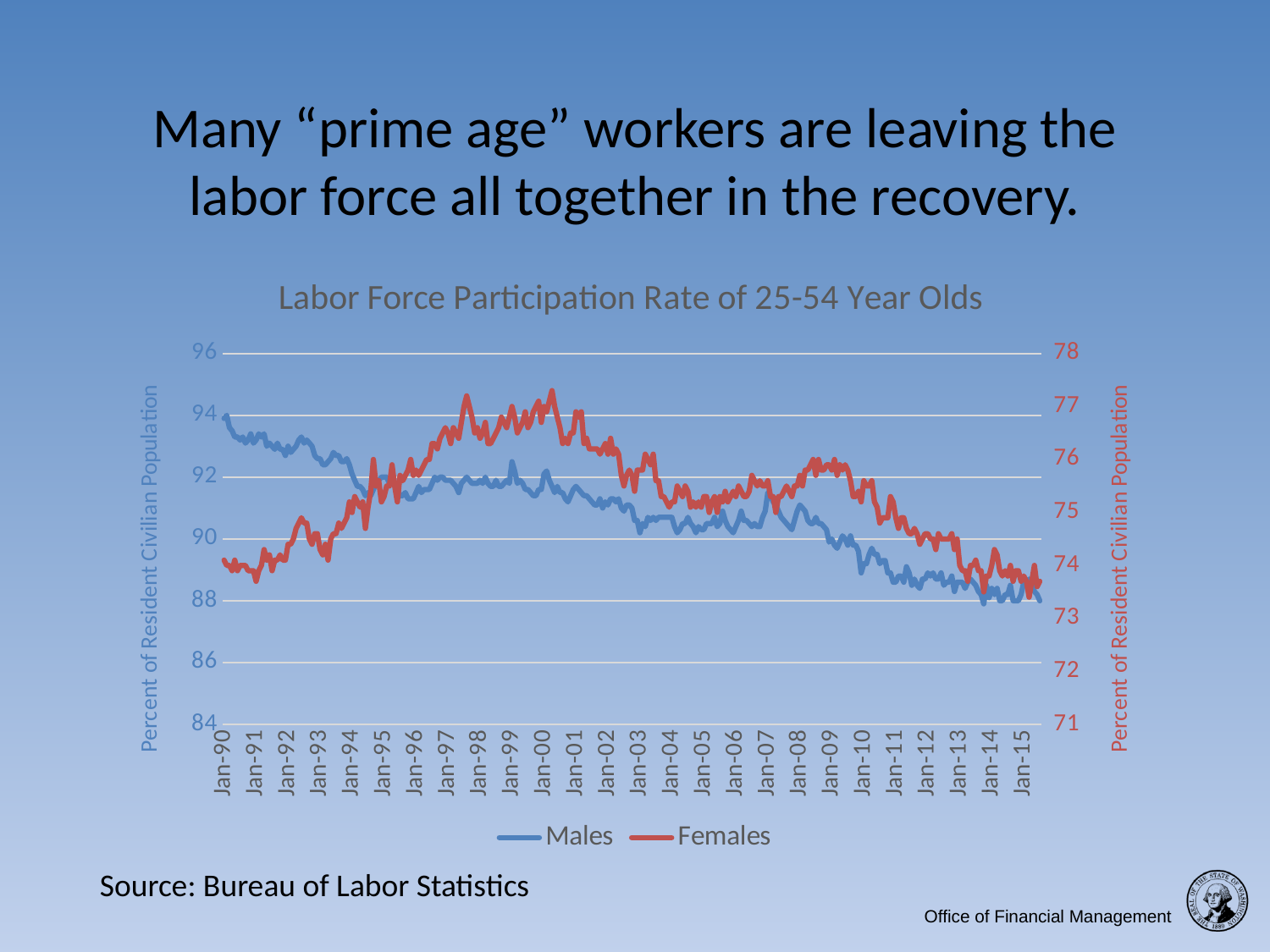
Does the Females series rise or fall from Jan-00 to Jan-15? Fall Which series is plotted against the right-hand axis (71 to 78)? Females Is the value for Females in Jan-90 greater or less than 75 on the right axis? less Does the Males series rise or fall overall from Jan-90 to Jan-15? Fall Around which year label does the Females series reach its highest point? Jan-00 Is the value for Males in Jan-90 greater or less than 92? greater Is the Males value larger in Jan-90 or in Jan-15? Jan-90 Is the value for Males in Jan-15 greater or less than 90? less What kind of chart is shown on the slide? Line chart How many series does the legend list? 2 What is the title of the chart? Labor Force Participation Rate of 25-54 Year Olds